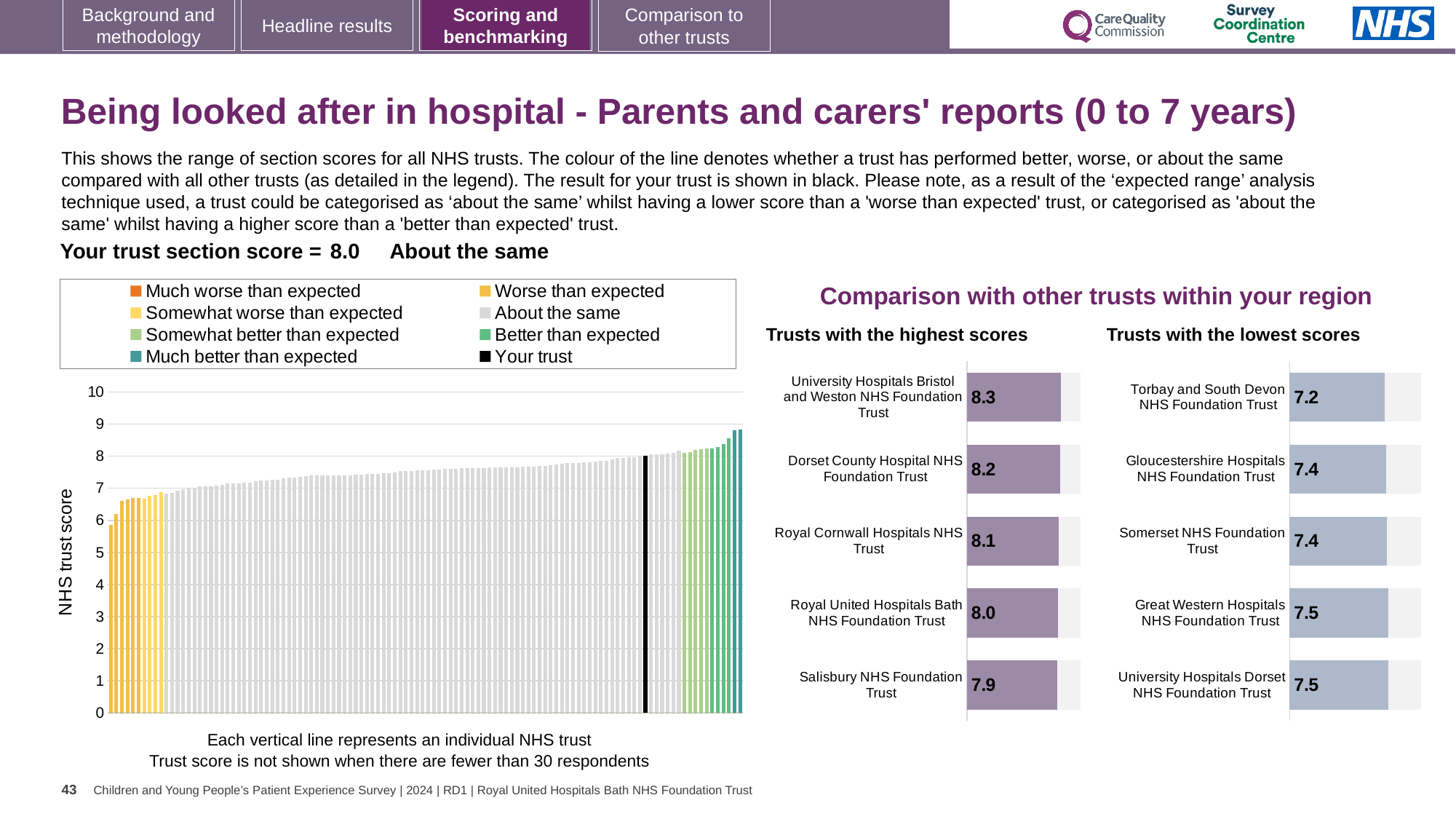
In the 'Trusts with the highest scores' chart, what is the score for University Hospitals Bristol and Weston NHS Foundation Trust? 8.3 How many entries does the legend above the 'NHS trust score' chart list? 8 In the 'Trusts with the highest scores' chart, what is the difference between the scores of University Hospitals Bristol and Weston NHS Foundation Trust and Salisbury NHS Foundation Trust? 0.4 What kind of chart is the large 'NHS trust score' chart on the left of the slide? Bar chart In the 'Trusts with the lowest scores' chart, which has the larger score: Torbay and South Devon NHS Foundation Trust or Great Western Hospitals NHS Foundation Trust? Great Western Hospitals NHS Foundation Trust In the 'Trusts with the highest scores' chart, which trust has the highest score? University Hospitals Bristol and Weston NHS Foundation Trust In the 'Trusts with the lowest scores' chart, what is the difference between the scores of University Hospitals Dorset NHS Foundation Trust and Torbay and South Devon NHS Foundation Trust? 0.3 In the 'Trusts with the highest scores' chart, how many trusts are shown? 5 In the 'Trusts with the highest scores' chart, what is the score for Salisbury NHS Foundation Trust? 7.9 In the 'Trusts with the lowest scores' chart, what is the score for Torbay and South Devon NHS Foundation Trust? 7.2 In the 'NHS trust score' chart on the left, is the value of the tallest bar greater or less than 8? greater In the 'Trusts with the lowest scores' chart, which trust has the lowest score? Torbay and South Devon NHS Foundation Trust